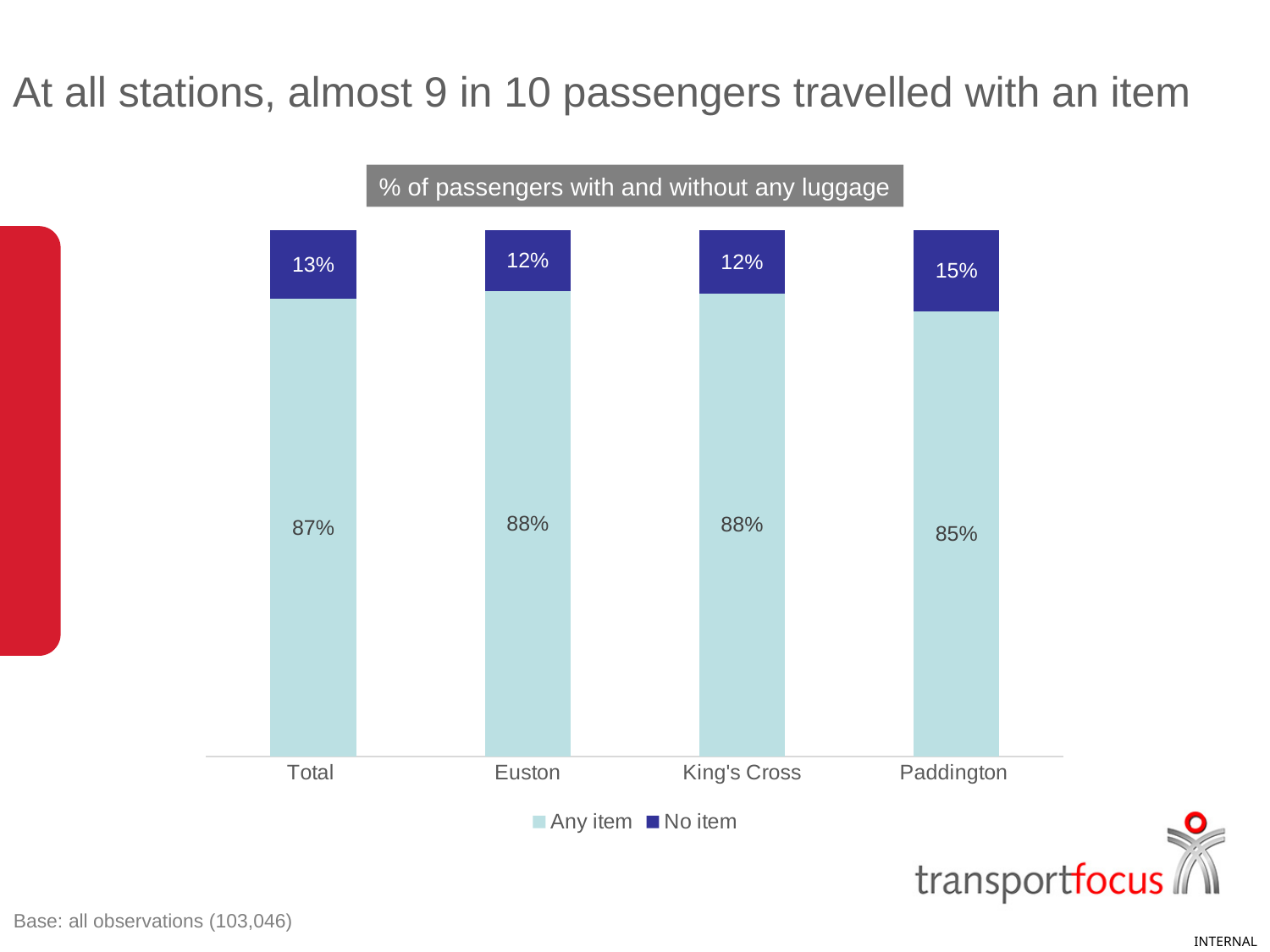
What is the title of the chart? % of passengers with and without any luggage What is the 'Any item' value for the Total category? 87% What percentage of passengers at Paddington travelled with no item? 15% How many categories are shown on the x axis? 4 What is the 'No item' value for King's Cross? 12% Which station has the lowest 'Any item' percentage? Paddington Which station has the highest 'No item' percentage? Paddington What is the difference between the 'Any item' percentages for Euston and Paddington? 3% Is the 'No item' percentage larger for Paddington or for Euston? Paddington How many series does the legend list? 2 What percentage of passengers at Euston travelled with any item? 88% What kind of chart is shown on the slide? Stacked bar chart